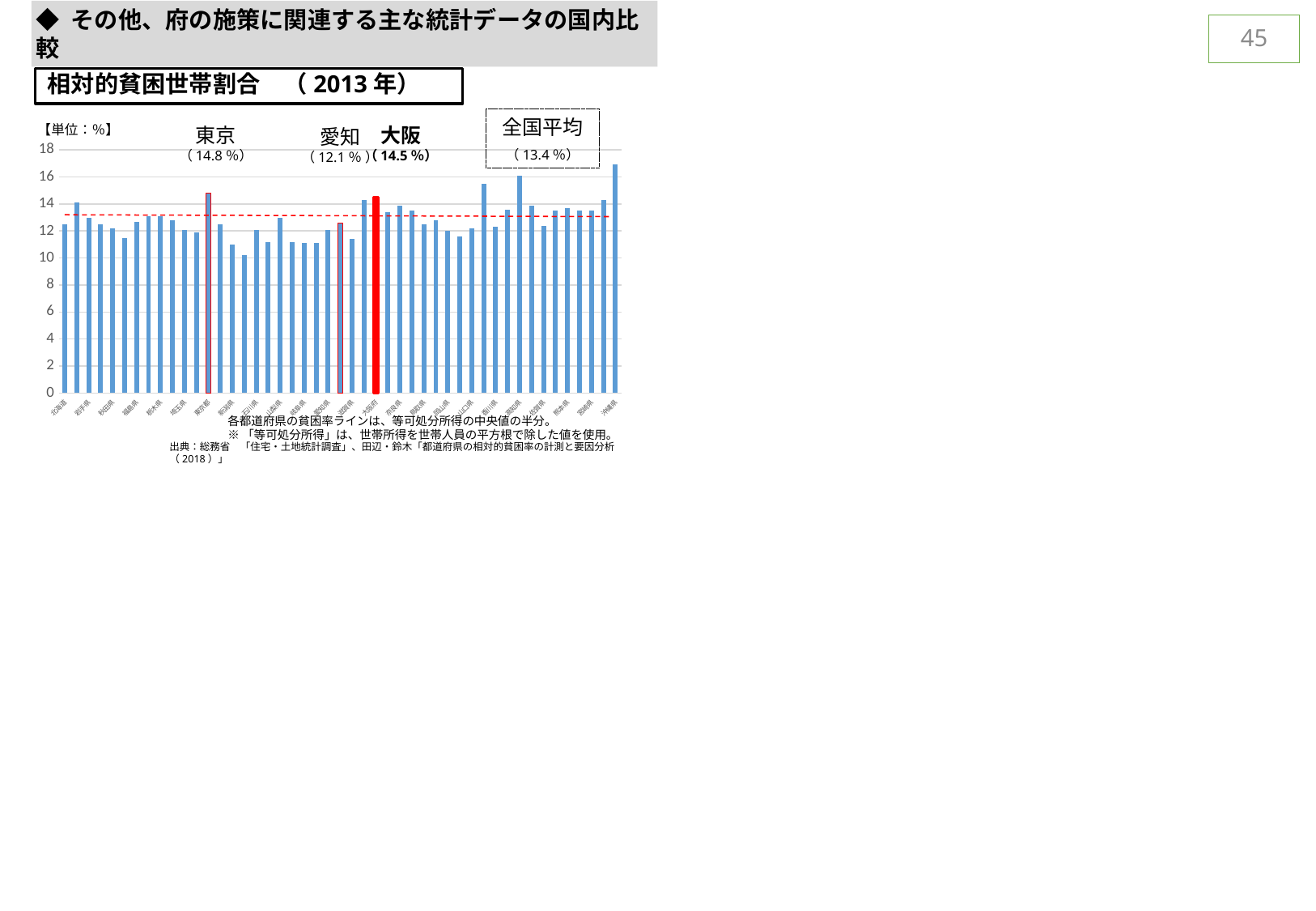
By how much does the rate for 大阪 exceed the national average (全国平均)? 1.1% What year does the chart title say the relative poverty household rate data is for? 2013年 What is the relative poverty household rate shown for 愛知 (Aichi)? 12.1% Which has the higher relative poverty household rate, 東京 or 大阪? 東京 Which is higher, the rate for 愛知 or the national average (全国平均)? 全国平均 What is the difference between the rates for 東京 and 愛知? 2.7% What kind of chart is used to show the relative poverty household rates? bar chart What is the difference between the rates for 東京 and 大阪? 0.3% What is the relative poverty household rate shown for 東京 (Tokyo)? 14.8% Is the value for 愛知 greater or less than 14? less What is the relative poverty household rate shown for 大阪 (Osaka)? 14.5% What is the national average (全国平均) relative poverty household rate shown on the chart? 13.4%